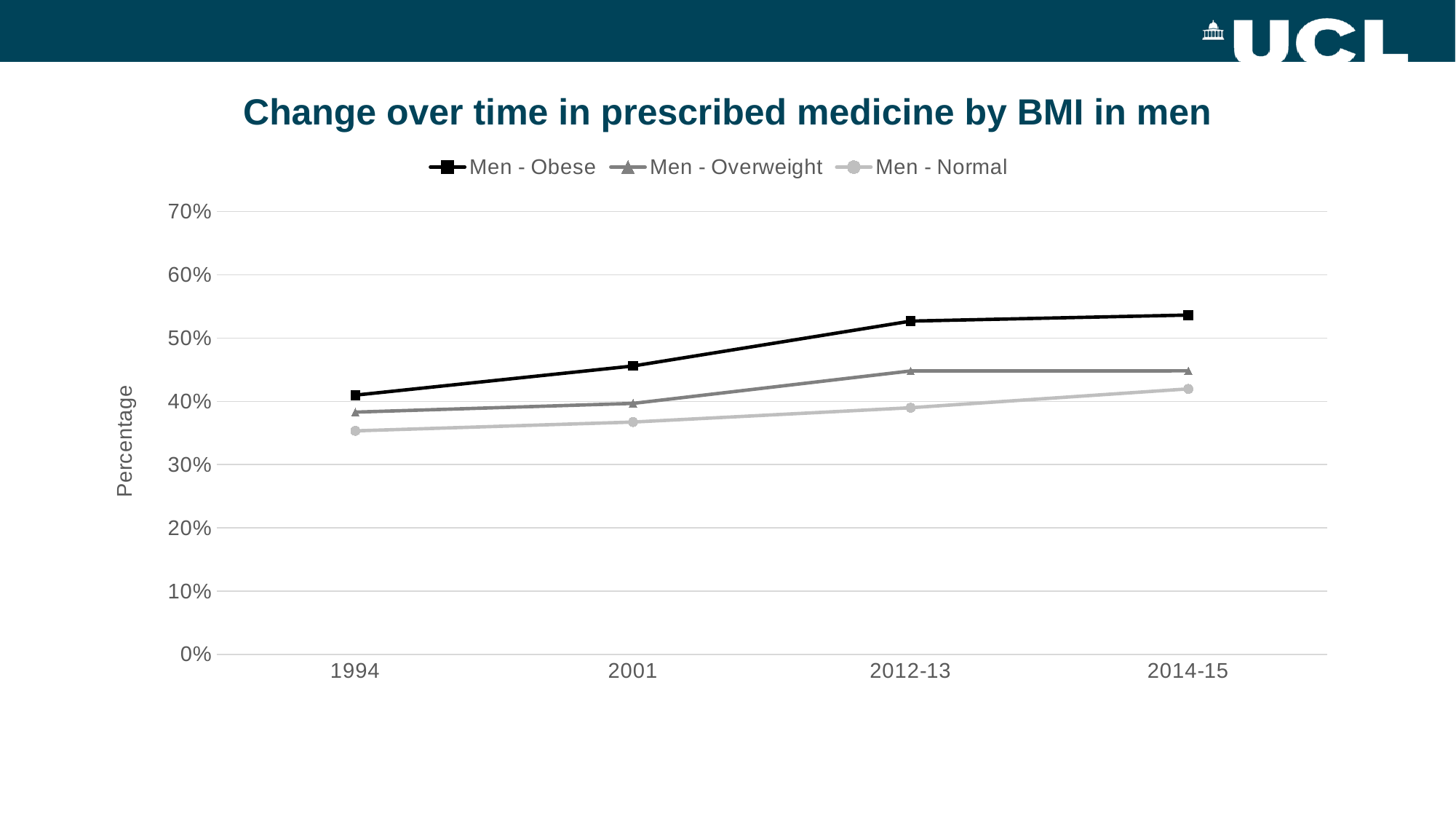
What kind of chart is shown on the slide? line chart What is the title of the chart? Change over time in prescribed medicine by BMI in men Is the value for Men - Obese in 2014-15 greater or less than 50%? greater Do the values for Men - Obese rise or fall from 1994 to 2014-15? rise What is the label on the vertical axis? Percentage How many series does the legend list? 3 Which series has the highest value in 2014-15? Men - Obese Which is larger, the value for Men - Obese in 2001 or the value for Men - Normal in 2001? Men - Obese in 2001 Which series has the lowest value in 1994? Men - Normal Is the value for Men - Overweight in 2001 greater or less than 50%? less Is the value for Men - Normal in 1994 greater or less than 40%? less How many time points are shown on the x axis? 4